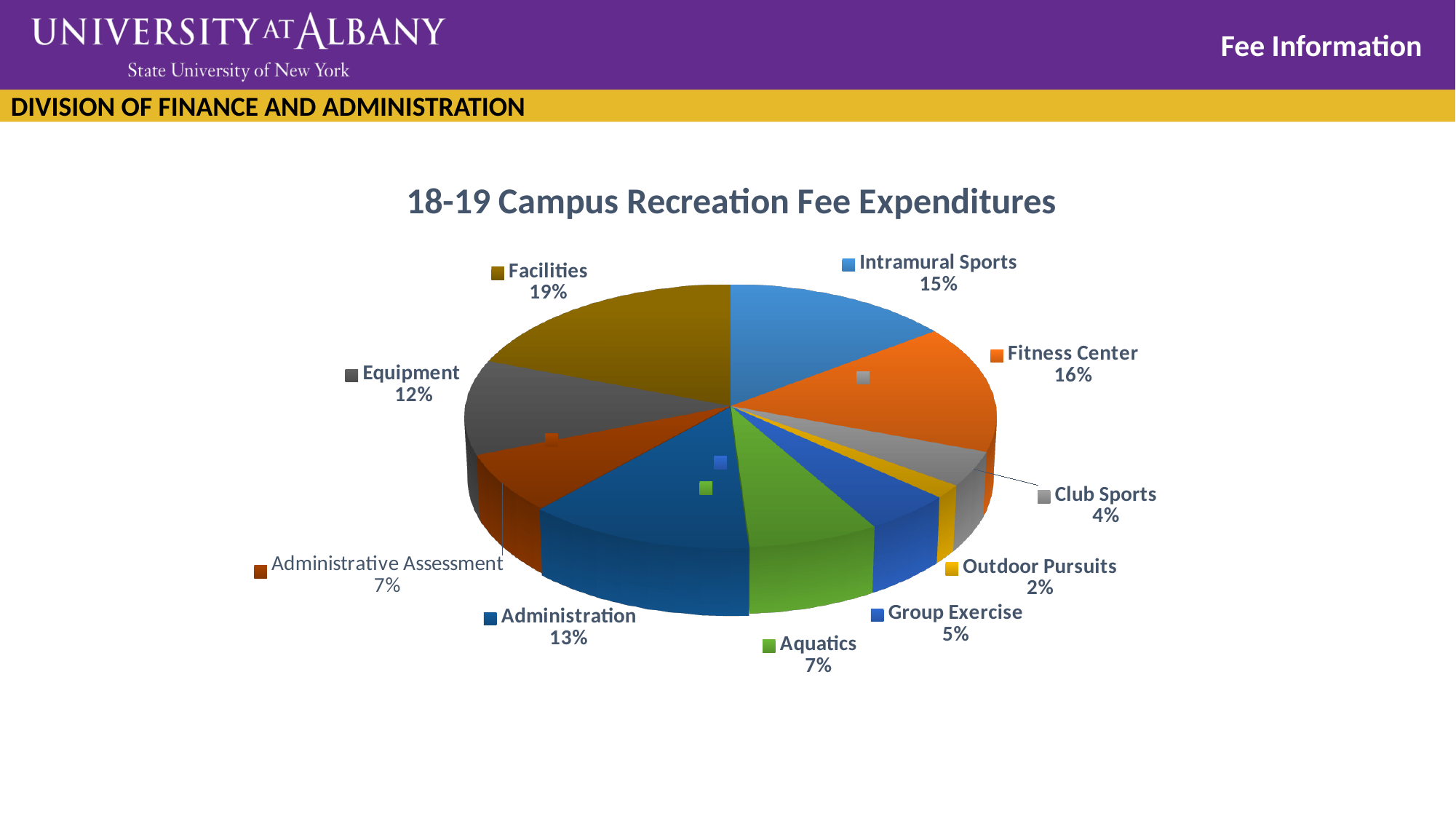
What percentage of expenditures is for the Fitness Center? 16% What share does Intramural Sports account for? 15% Which is larger, the share for Club Sports or the share for Group Exercise? Group Exercise How many categories are shown in the pie chart? 10 What is the title of the chart? 18-19 Campus Recreation Fee Expenditures What percentage is shown for Outdoor Pursuits? 2% Which is larger, the share for Administration or the share for Equipment? Administration What type of chart is shown on the slide? Pie chart Which category has the largest share of the expenditures? Facilities What is the difference in percentage points between Facilities and Equipment? 7 What share of the 18-19 Campus Recreation Fee Expenditures goes to Facilities? 19% Which category has the smallest share of the expenditures? Outdoor Pursuits